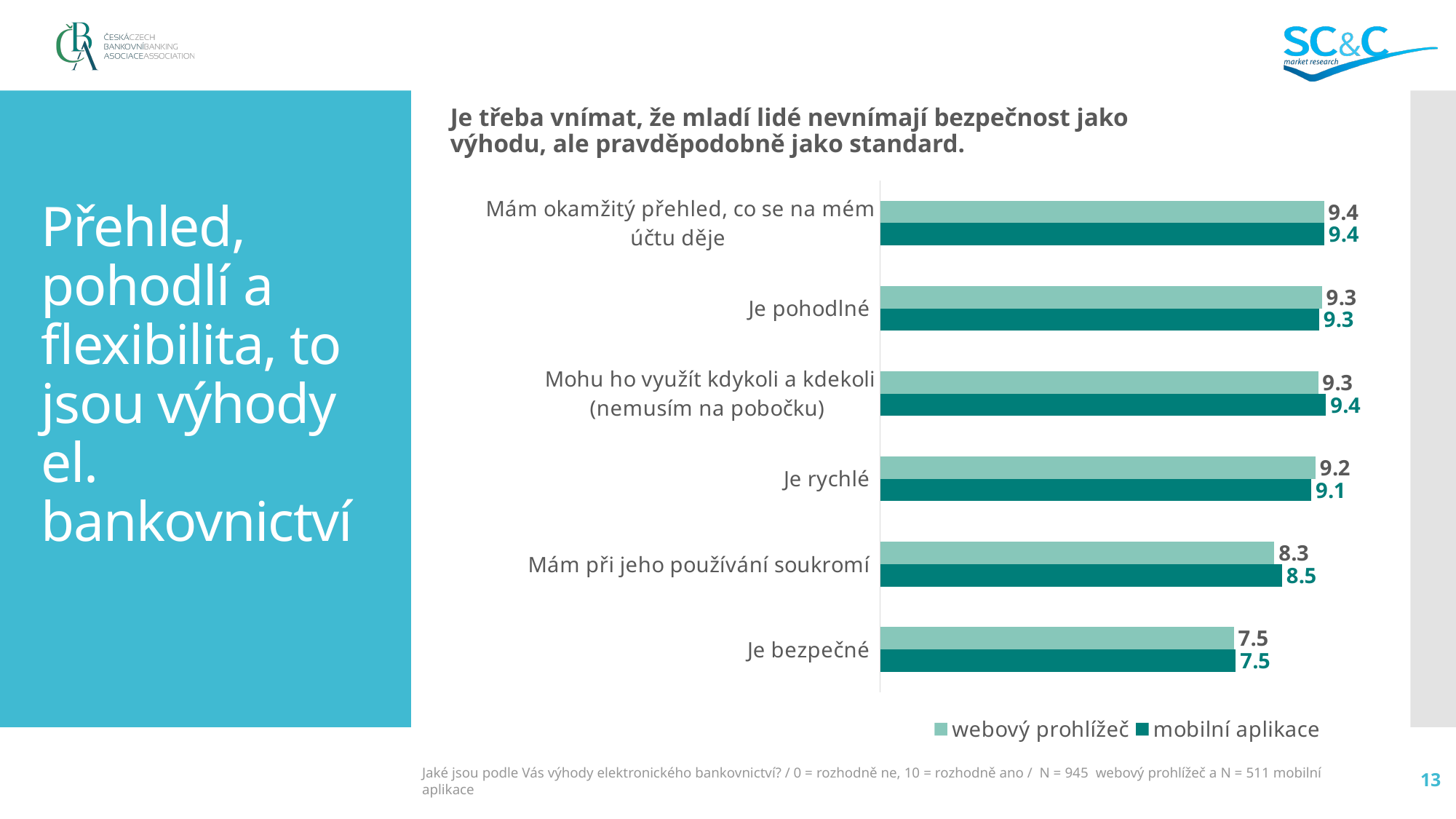
Which category has the highest value for "webový prohlížeč"? Mám okamžitý přehled, co se na mém účtu děje What is the difference between the "webový prohlížeč" values for "Je pohodlné" and "Je bezpečné"? 1.8 What is the difference between the "mobilní aplikace" and "webový prohlížeč" values for "Mám při jeho používání soukromí"? 0.2 What is the value for "mobilní aplikace" for "Je rychlé"? 9.1 What is the value for "mobilní aplikace" for "Mám při jeho používání soukromí"? 8.5 For "Je rychlé", which series has the larger value, "webový prohlížeč" or "mobilní aplikace"? webový prohlížeč How many categories are shown on the chart? 6 What kind of chart is shown on the slide? bar chart What is the value for "webový prohlížeč" for "Je bezpečné"? 7.5 How many series does the legend list? 2 What is the value for "webový prohlížeč" for "Mohu ho využít kdykoli a kdekoli (nemusím na pobočku)"? 9.3 Which category has the lowest value for "mobilní aplikace"? Je bezpečné